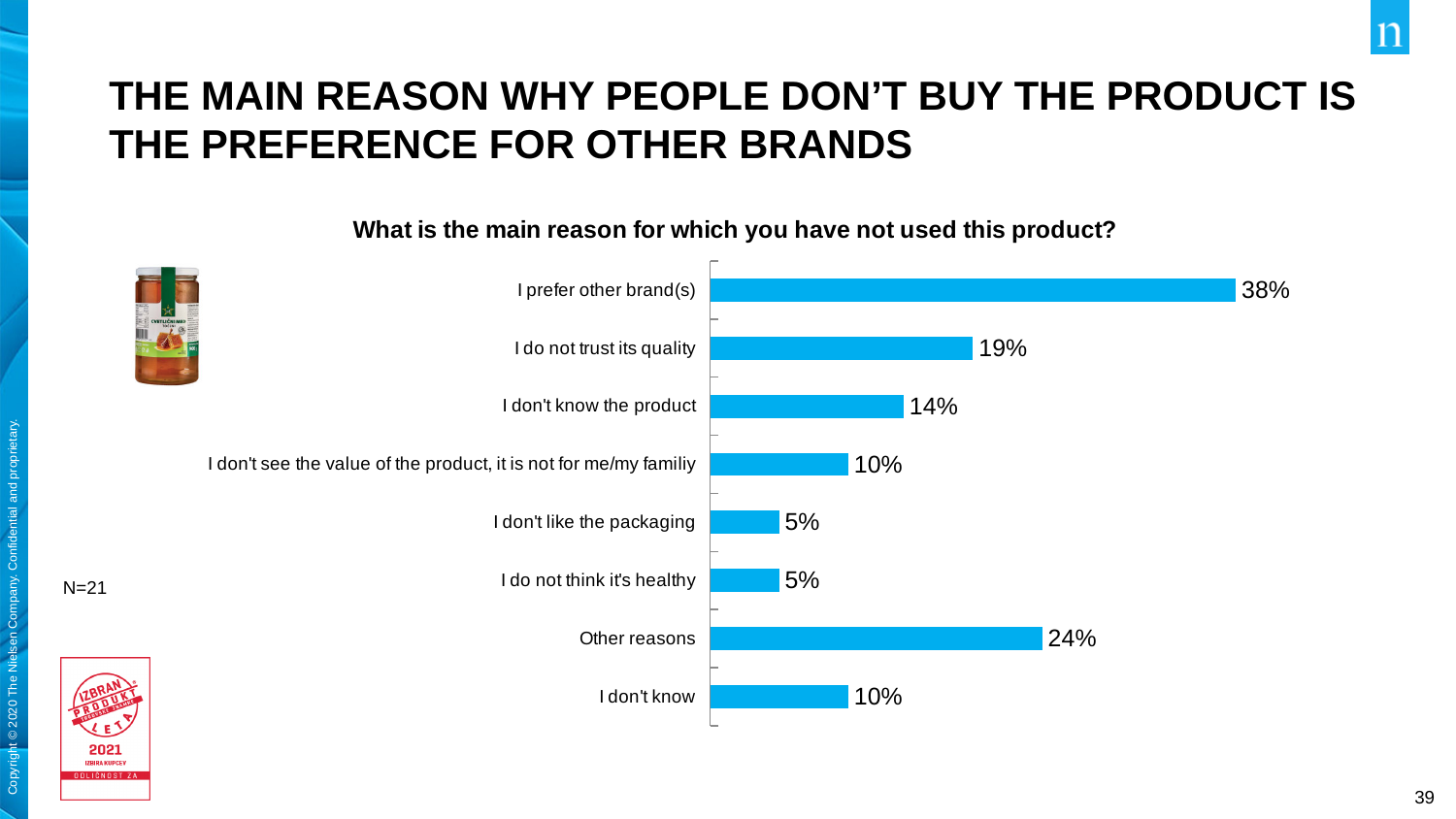
What is the value for "I don't like the packaging"? 5% What question is the chart based on? What is the main reason for which you have not used this product? What is the value for "I do not trust its quality"? 19% What is the difference between "I prefer other brand(s)" and "I do not trust its quality"? 19% How many reasons (categories) are shown in the chart? 8 What kind of chart is shown on the slide? Bar chart What is the sample size (N) shown on the slide? N=21 Which is larger: "I don't know the product" or "Other reasons"? Other reasons What is the difference between "Other reasons" and "I don't know"? 14% Which reason has the highest percentage? I prefer other brand(s) What percentage of respondents said "I prefer other brand(s)"? 38% What percentage chose "Other reasons"? 24%